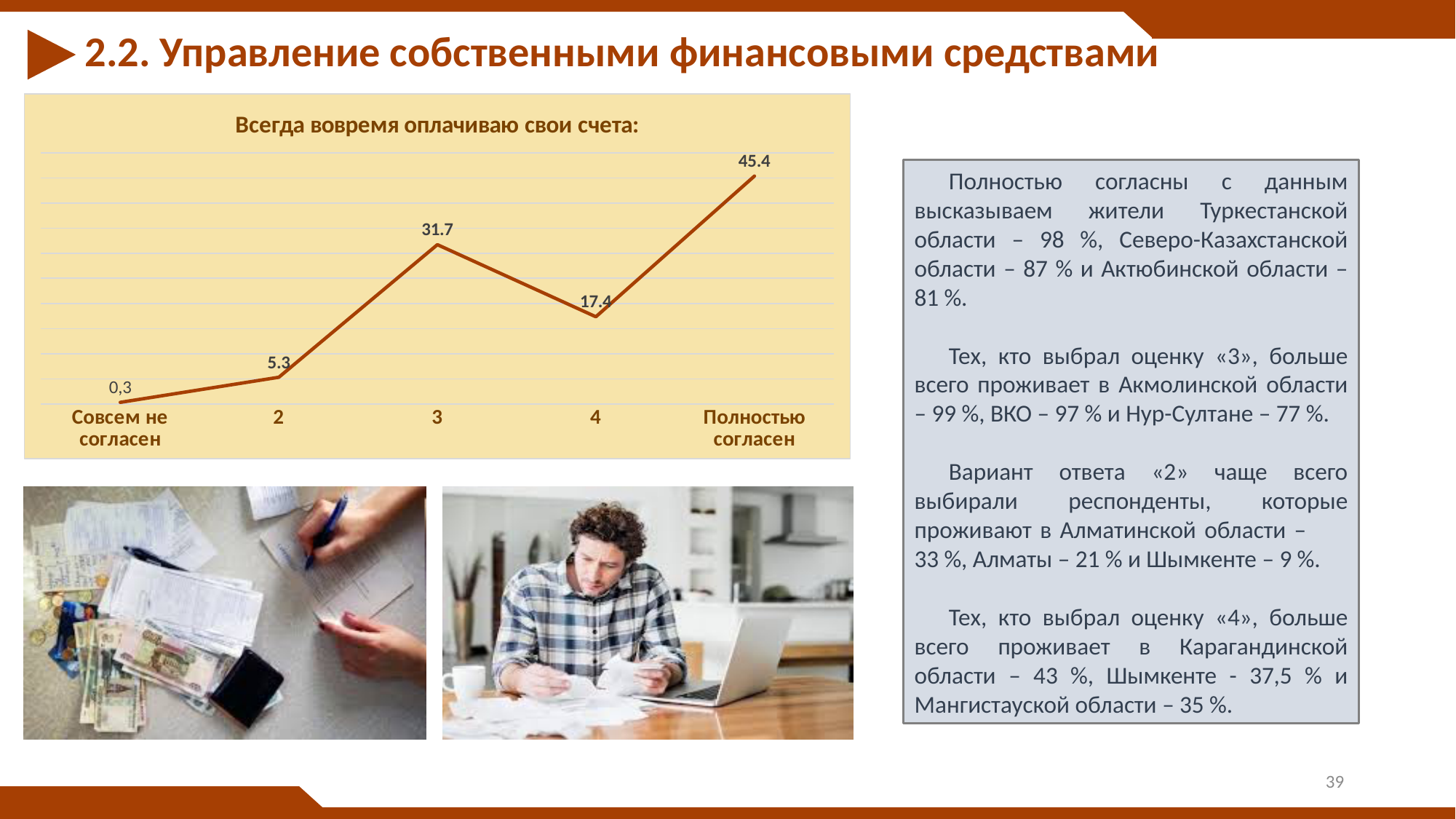
What type of chart is shown on the slide? line chart What is the value for category "3"? 31.7 What is the value for category "4"? 17.4 How many data points are plotted on the line? 5 Which category has the lowest value? Совсем не согласен What is the difference between the values for "Полностью согласен" and "3"? 13.7 What is the title of the chart? Всегда вовремя оплачиваю свои счета: Does the value rise or fall from category "3" to category "4"? fall What is the value for "Совсем не согласен"? 0,3 Which category has the highest value? Полностью согласен Which is larger, the value for "3" or the value for "4"? 3 What is the value for "Полностью согласен"? 45.4